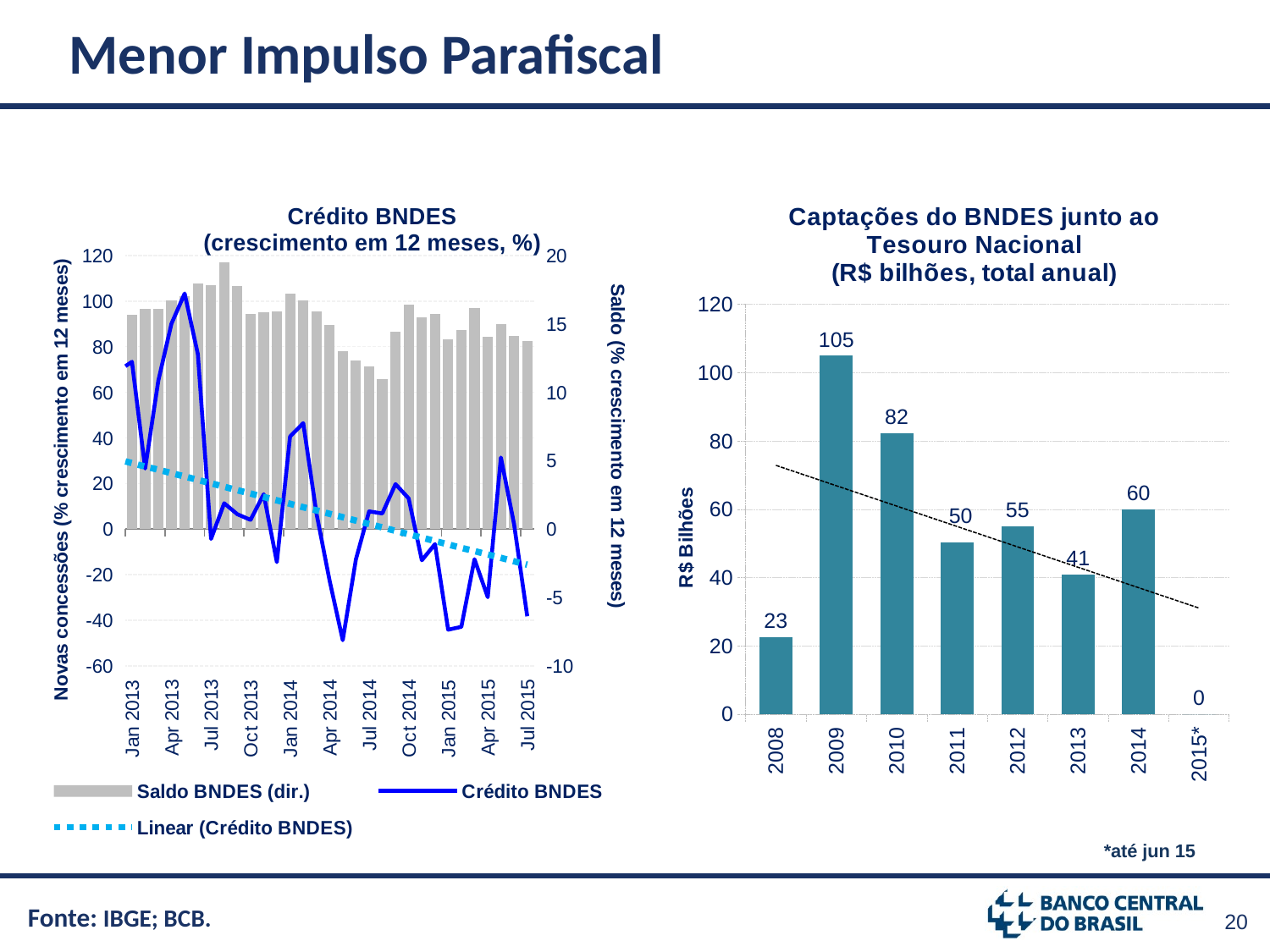
In the 'Captações do BNDES junto ao Tesouro Nacional' chart, what is the difference between the values for 2009 and 2010? 23 In the 'Captações do BNDES junto ao Tesouro Nacional' chart, how many years are shown on the x axis? 8 In the 'Captações do BNDES junto ao Tesouro Nacional' chart, what is the label on the y axis? R$ Bilhões What kind of chart is the 'Captações do BNDES junto ao Tesouro Nacional' chart? Bar chart In the 'Crédito BNDES (crescimento em 12 meses, %)' chart, is the Saldo BNDES (dir.) value for Jul 2013 greater or less than 15 on the right axis? greater In the 'Captações do BNDES junto ao Tesouro Nacional' chart, which is larger, the value for 2011 or the value for 2012? 2012 In the 'Captações do BNDES junto ao Tesouro Nacional' chart, what is the value for 2009? 105 In the 'Captações do BNDES junto ao Tesouro Nacional' chart, which year has the lowest value? 2015* How many series does the legend of the 'Crédito BNDES (crescimento em 12 meses, %)' chart list? 3 In the 'Captações do BNDES junto ao Tesouro Nacional' chart, what is the value for 2013? 41 In the 'Captações do BNDES junto ao Tesouro Nacional' chart, what is the value for 2014? 60 In the 'Captações do BNDES junto ao Tesouro Nacional' chart, which year has the highest value? 2009